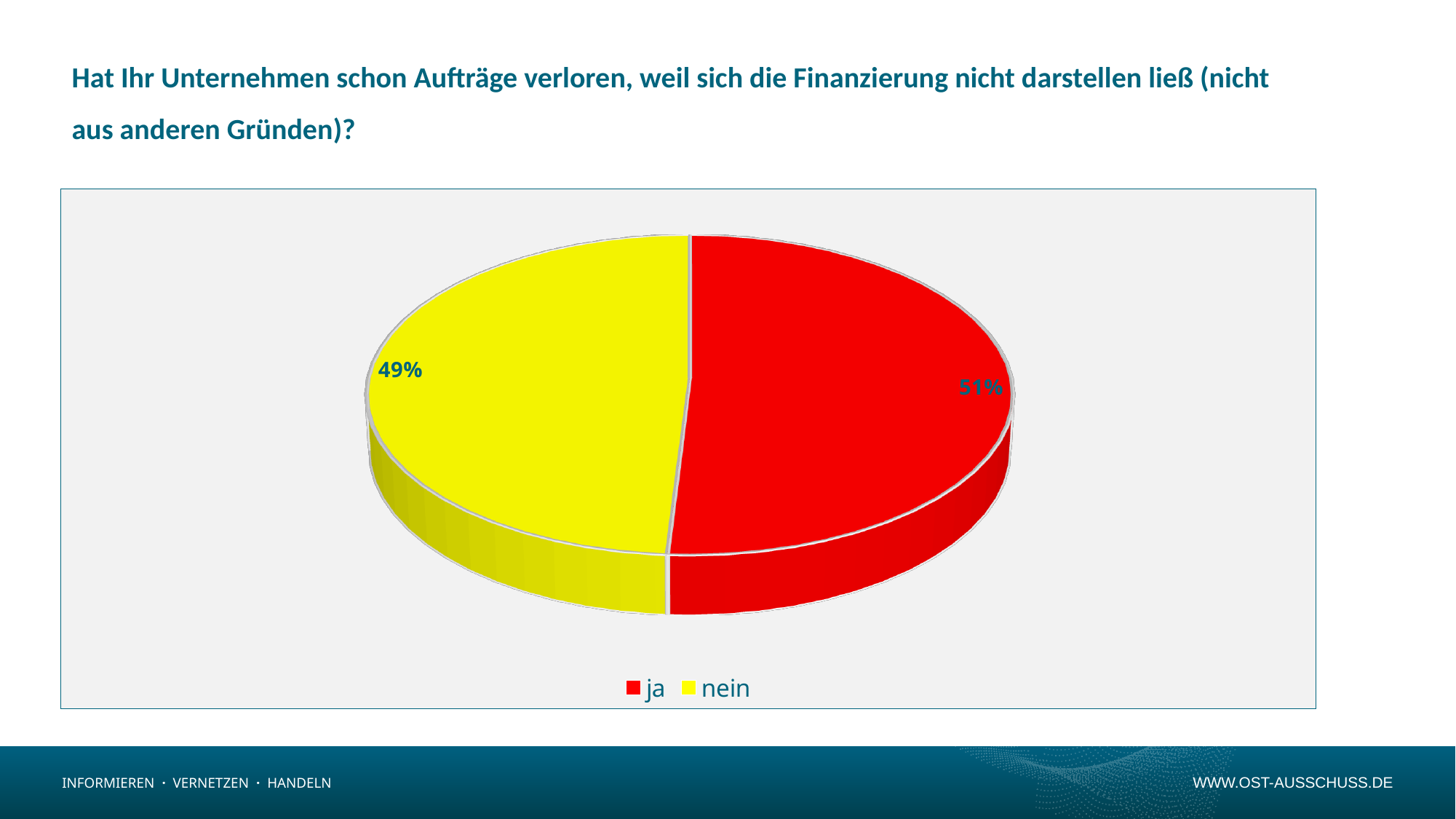
Which is larger, the "ja" slice or the "nein" slice? ja What share of the pie is labelled "ja"? 51% Which slice of the pie is the largest? ja What colour is the "ja" slice? Red What kind of chart is shown on the slide? Pie chart How many entries does the legend list? 2 What colour is the "nein" slice? Yellow What share of the pie is labelled "nein"? 49% Is the share for "ja" greater or less than 50%? greater How many slices does the pie chart have? 2 Which slice of the pie is the smallest? nein What is the difference in percentage points between the "ja" and "nein" slices? 2 percentage points